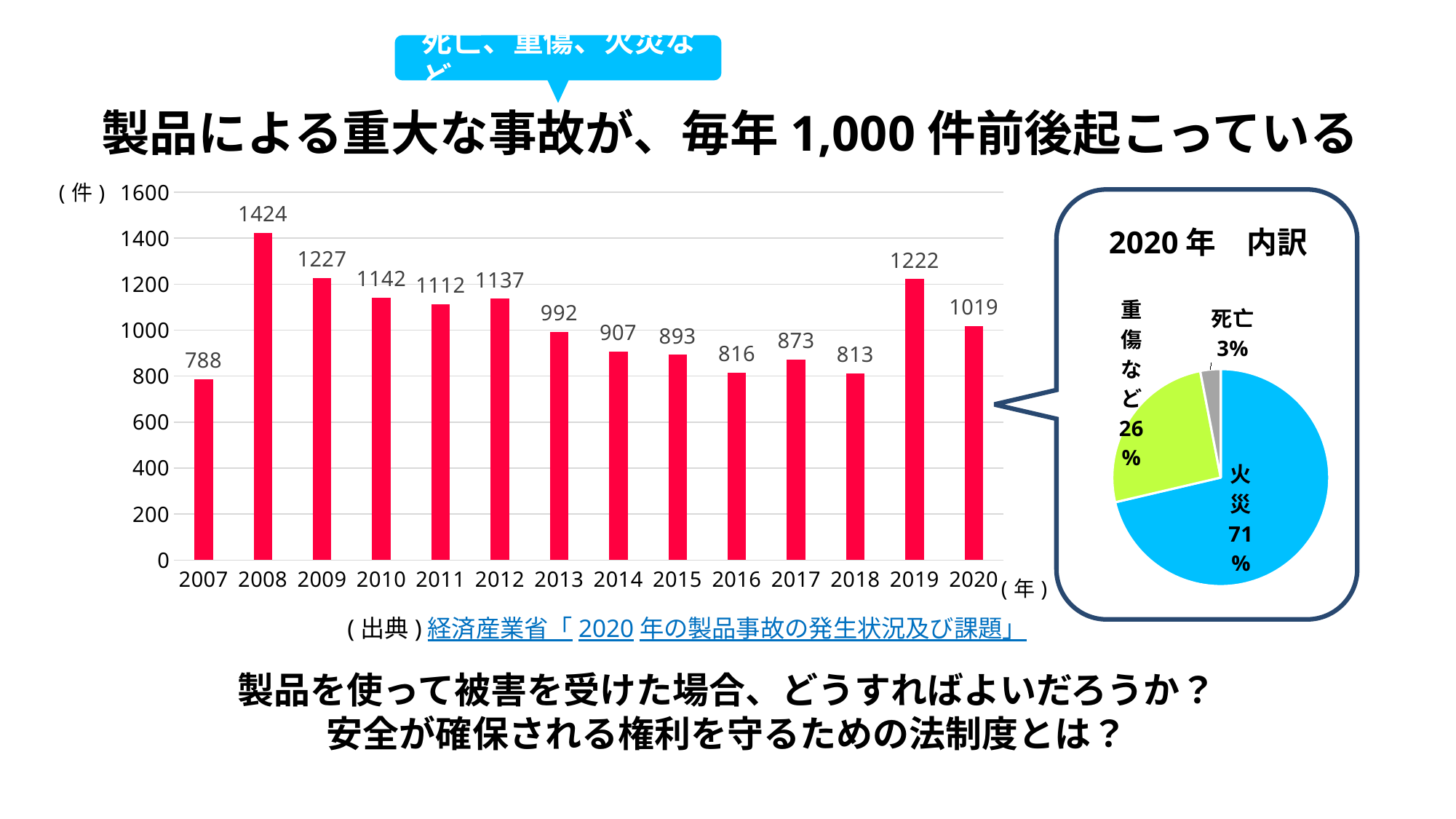
In the bar chart on the left, what is the value for 2020? 1019 In the bar chart on the left, do the values rise or fall from 2012 to 2016? fall In the pie chart titled 2020年 内訳, what share does 火災 have? 71% In the bar chart on the left, what is the value for 2008? 1424 In the bar chart on the left, which year has the highest value? 2008 In the pie chart titled 2020年 内訳, which category has the smallest share? 死亡 In the bar chart on the left, how many years are shown on the x axis? 14 In the bar chart on the left, what is the difference between the values for 2019 and 2018? 409 In the bar chart on the left, which year has the lowest value? 2007 What kind of chart is the chart on the left? bar chart In the bar chart on the left, which is larger, the value for 2010 or the value for 2012? 2010 In the pie chart titled 2020年 内訳, how many slices are there? 3